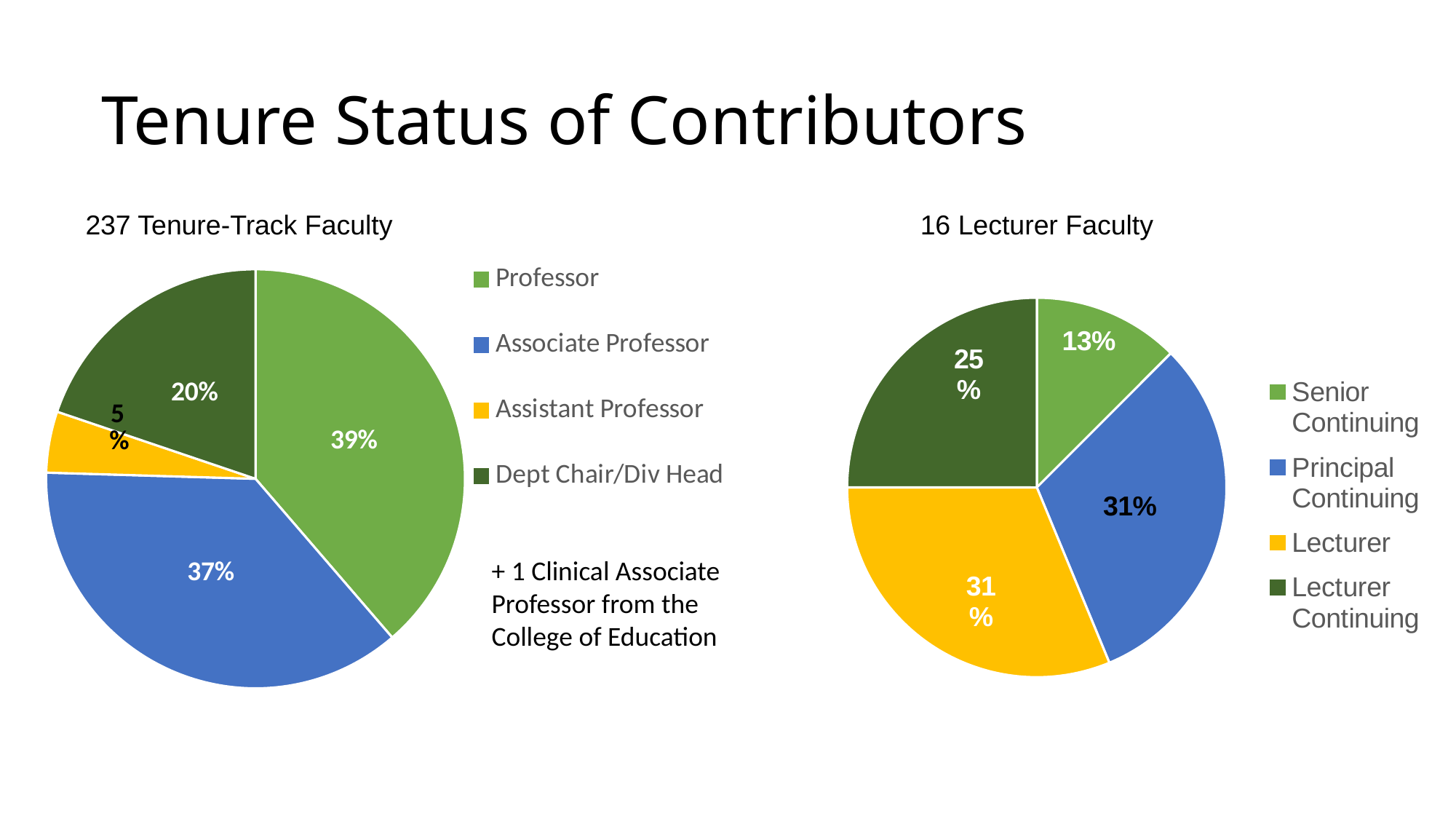
What kind of chart is the '16 Lecturer Faculty' chart? Pie chart In the '237 Tenure-Track Faculty' pie chart, which category has the smallest slice? Assistant Professor In the '237 Tenure-Track Faculty' pie chart, how many categories does the legend list? 4 In the '16 Lecturer Faculty' pie chart, which category has the smallest slice? Senior Continuing In the '237 Tenure-Track Faculty' pie chart, what share of the pie is Assistant Professor? 5% In the '16 Lecturer Faculty' pie chart, what share of the pie is Senior Continuing? 13% In the '16 Lecturer Faculty' pie chart, what share of the pie is Lecturer Continuing? 25% In the '16 Lecturer Faculty' pie chart, which is larger, Lecturer Continuing or Senior Continuing? Lecturer Continuing In the '16 Lecturer Faculty' pie chart, what colour is the Lecturer slice? Yellow In the '237 Tenure-Track Faculty' pie chart, what is the difference in percentage points between Dept Chair/Div Head and Assistant Professor? 15